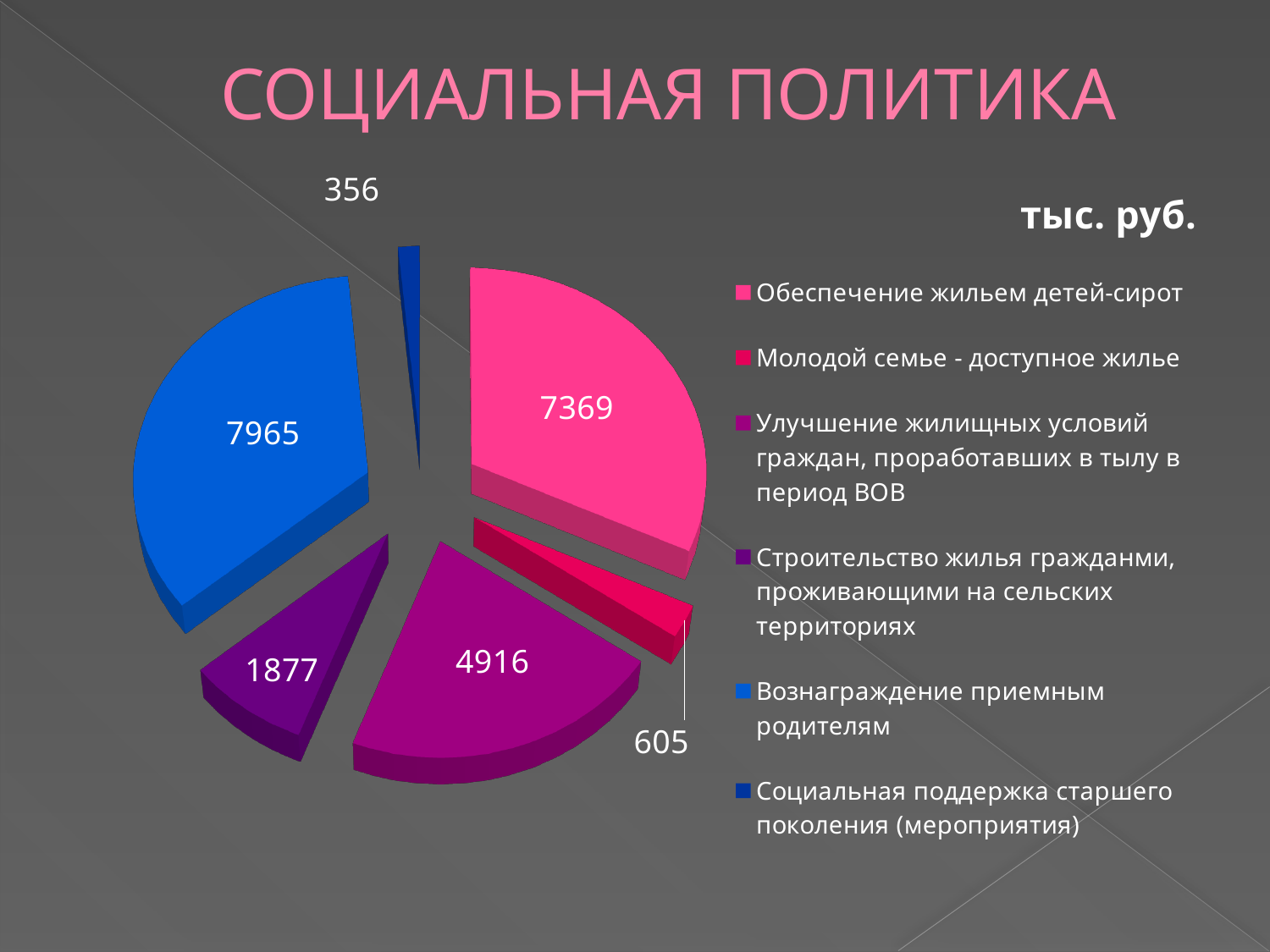
What is the difference between the values for Улучшение жилищных условий граждан, проработавших в тылу в период ВОВ and Строительство жилья гражданми, проживающими на сельских территориях? 3039 Which category has the largest value? Вознаграждение приемным родителям What is the value for Вознаграждение приемным родителям? 7965 What unit is indicated for the chart values? тыс. руб. What is the value for Молодой семье - доступное жилье? 605 Which is larger: the value for Молодой семье - доступное жилье or the value for Социальная поддержка старшего поколения (мероприятия)? Молодой семье - доступное жилье What type of chart is shown on the slide? pie chart What is the value for Строительство жилья гражданми, проживающими на сельских территориях? 1877 What is the difference between the values for Вознаграждение приемным родителям and Обеспечение жильем детей-сирот? 596 Which category has the smallest value? Социальная поддержка старшего поколения (мероприятия) What is the value for Обеспечение жильем детей-сирот? 7369 How many slices does the pie chart have? 6